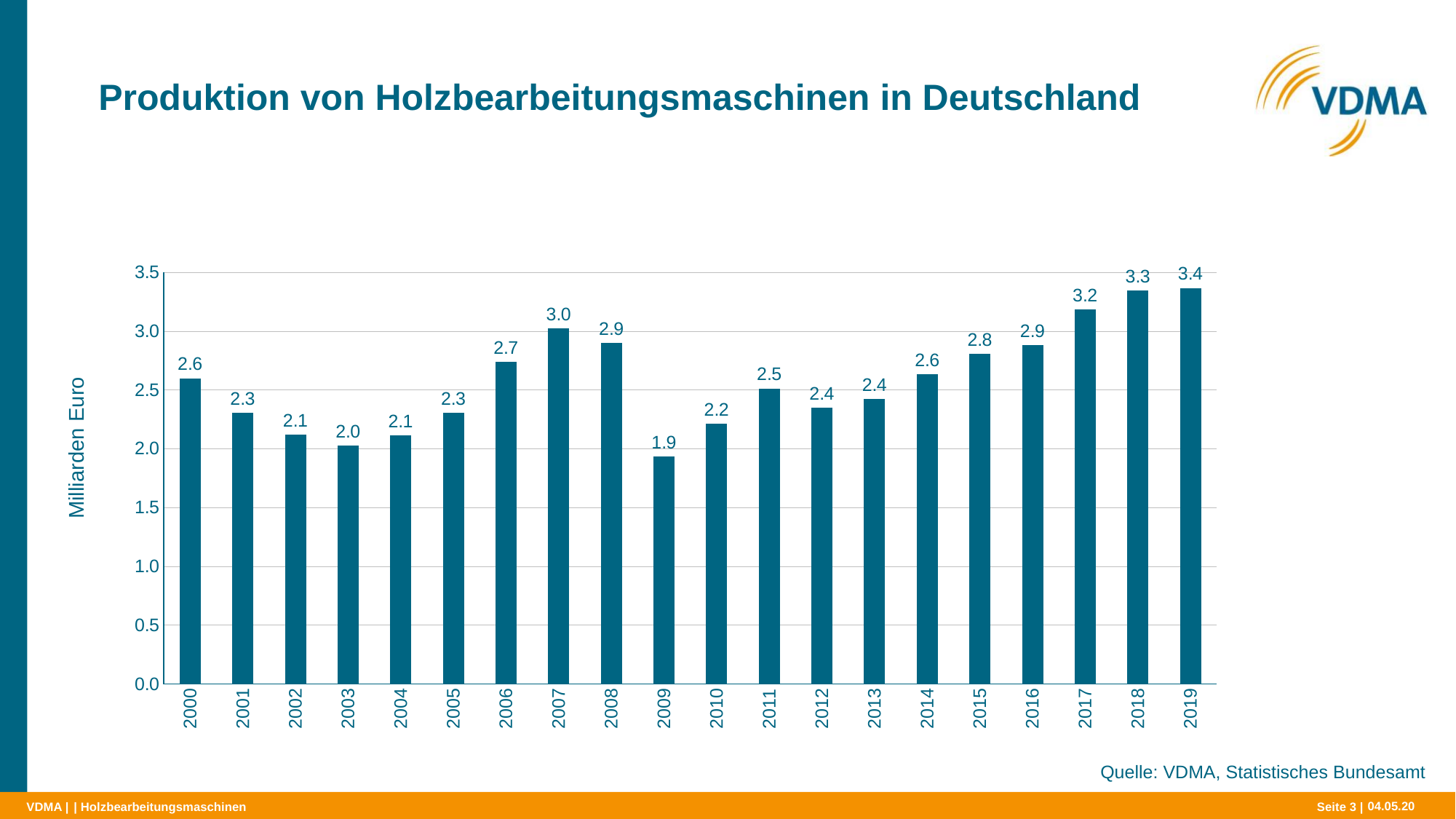
What is the difference between the production values for 2019 and 2009? 1.5 How many years are shown on the x axis? 20 What is the production value for 2009? 1.9 Is the value for 2017 greater or less than 3.0? greater Which year has the highest production value? 2019 Which year has the lowest production value? 2009 What kind of chart is shown on the slide? bar chart What is the label of the y axis? Milliarden Euro What is the production value for 2007? 3.0 Do the values rise or fall from 2013 to 2019? rise What is the production value for 2019? 3.4 Which year has the larger production value, 2006 or 2010? 2006